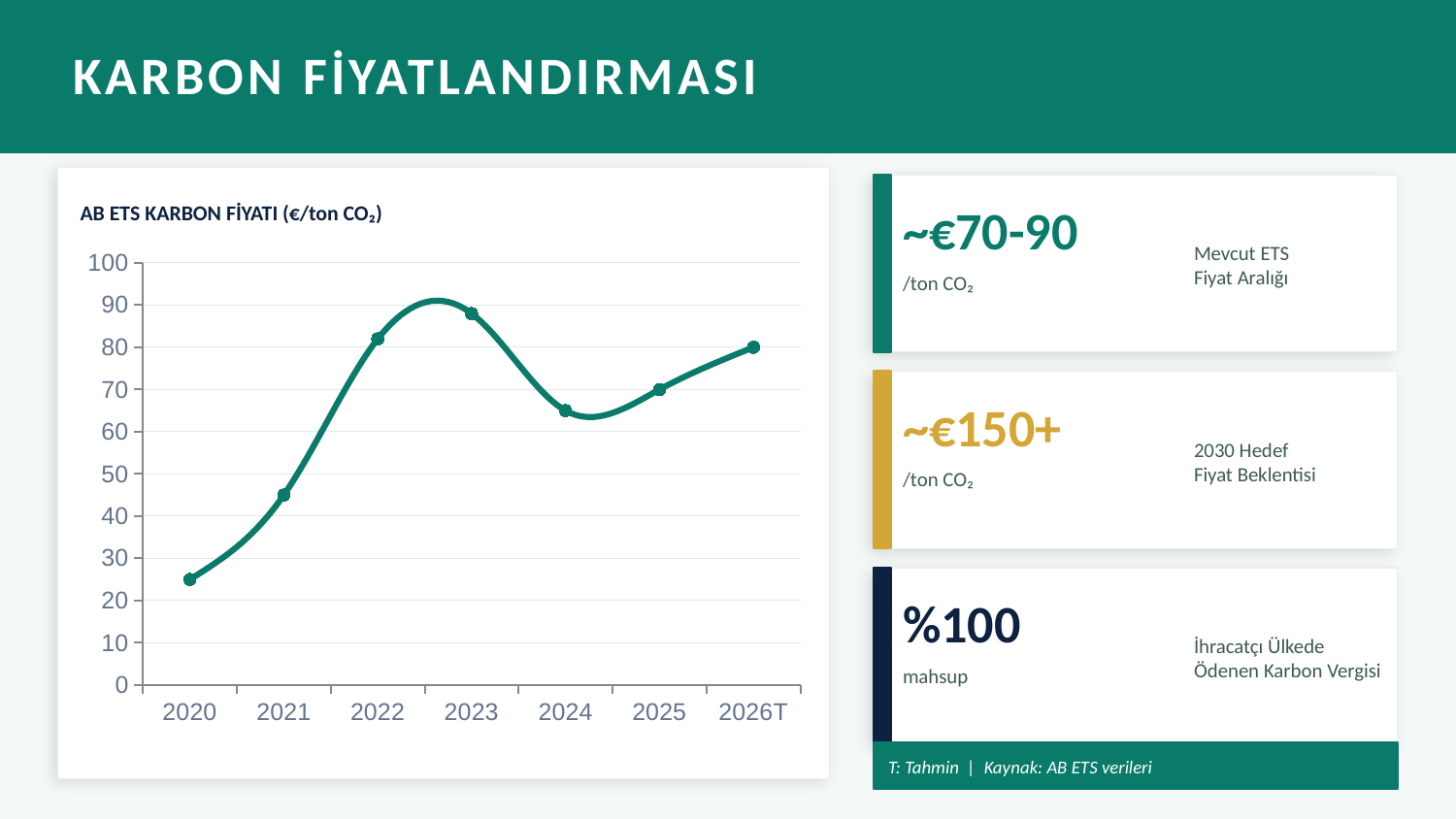
Which is larger, the value for 2022 or the value for 2024? 2022 How many data points are plotted on the chart? 7 What is the title of the chart? AB ETS KARBON FİYATI (€/ton CO₂) What is the source cited for the chart data? AB ETS verileri Do the values rise or fall from 2020 to 2023? rise Is the value for 2024 greater or less than 60? greater Is the value for 2020 greater or less than 30? less Which year has the lowest carbon price on the chart? 2020 Is the value for 2021 greater or less than 50? less What kind of chart is shown on the slide? line chart Which year has the highest carbon price on the chart? 2023